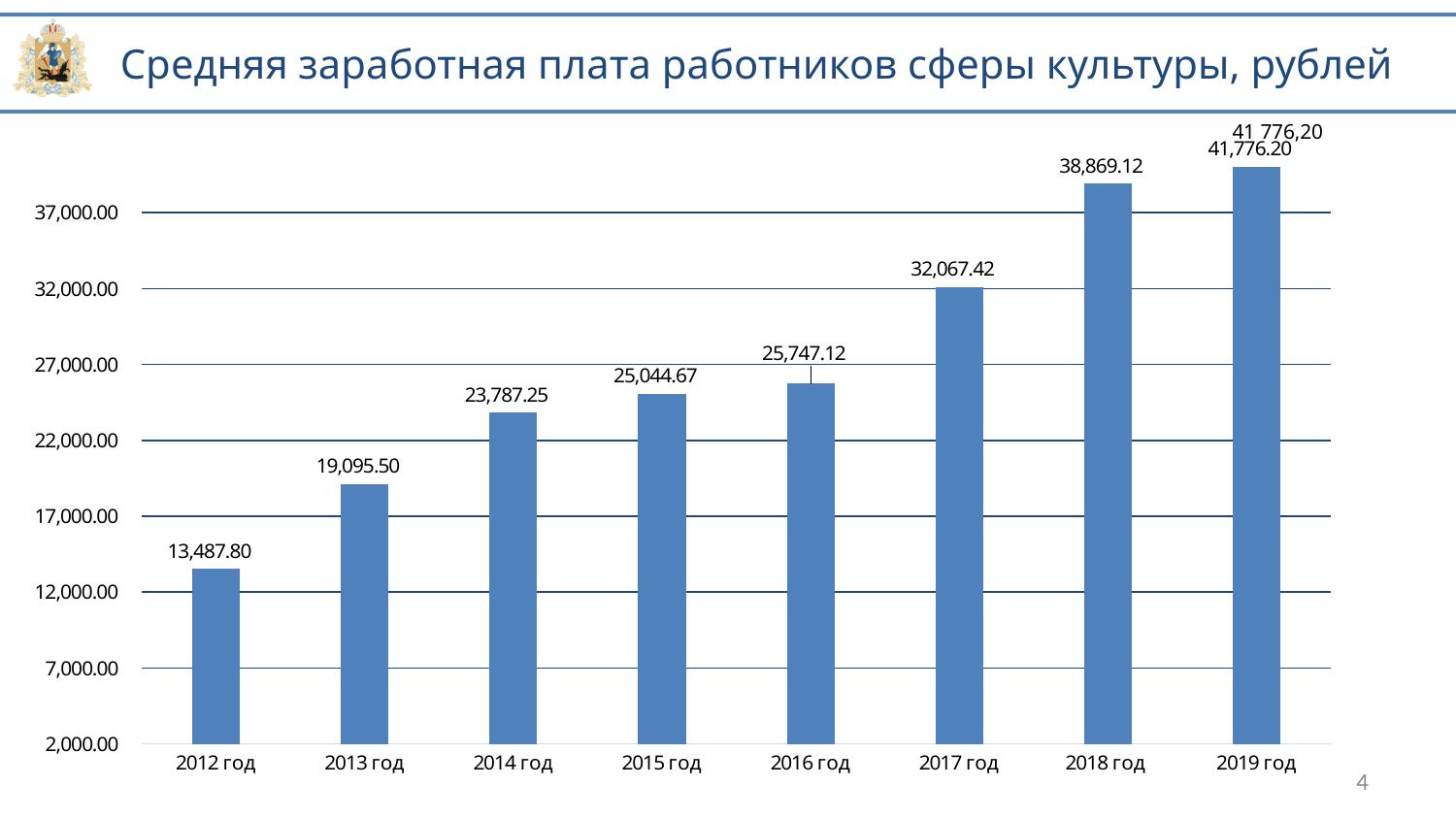
What is the value for 2012 год? 13,487.80 Is the value for 2014 год greater or less than 22,000.00? greater What is the difference between the values for 2019 год and 2018 год? 2,907.08 What is the difference between the values for 2013 год and 2012 год? 5,607.70 Which is larger, the value for 2017 год or the value for 2015 год? 2017 год Which year has the lowest value? 2012 год What is the value for 2018 год? 38,869.12 Which year has the highest value? 2019 год Do the values rise or fall from 2012 год to 2019 год? rise What is the value for 2016 год? 25,747.12 How many years are shown on the x axis? 8 What kind of chart is shown on the slide? bar chart